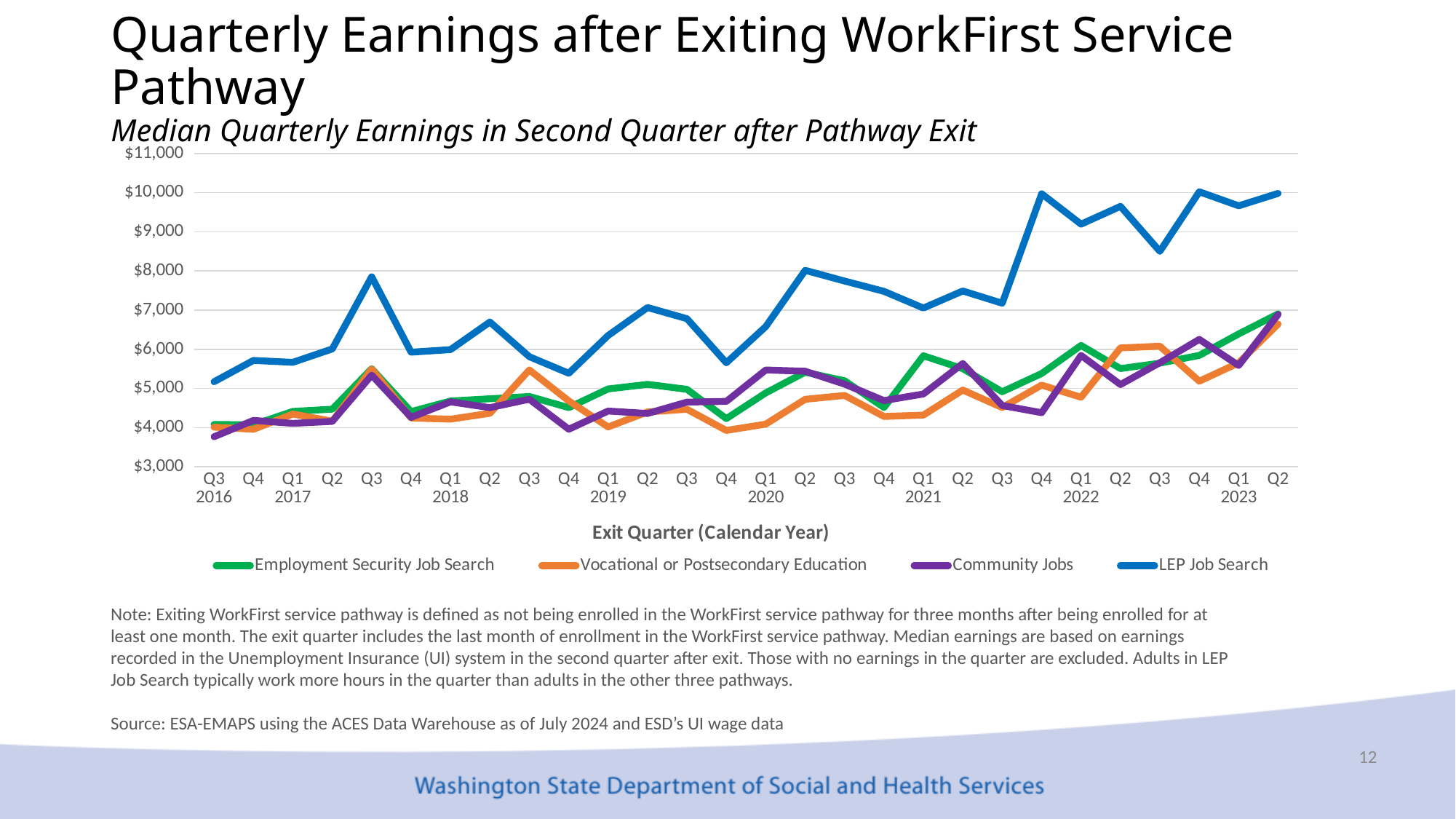
How many exit quarters are plotted along the x axis? 28 What is the x-axis title of the chart? Exit Quarter (Calendar Year) Is the value for LEP Job Search in Q3 2017 greater or less than $7,000? greater How many series does the legend list? 4 Is the value for LEP Job Search in Q4 2019 greater or less than $6,000? less Which series has the highest median quarterly earnings in Q4 2021? LEP Job Search In Q2 2023, which is larger: the value for LEP Job Search or the value for Employment Security Job Search? LEP Job Search Is the value for LEP Job Search in Q4 2021 greater or less than $9,000? greater Which series has the lowest median quarterly earnings in Q4 2019? Vocational or Postsecondary Education Does the LEP Job Search line generally rise or fall from Q3 2016 to Q2 2023? rise What kind of chart is shown on the slide? line chart